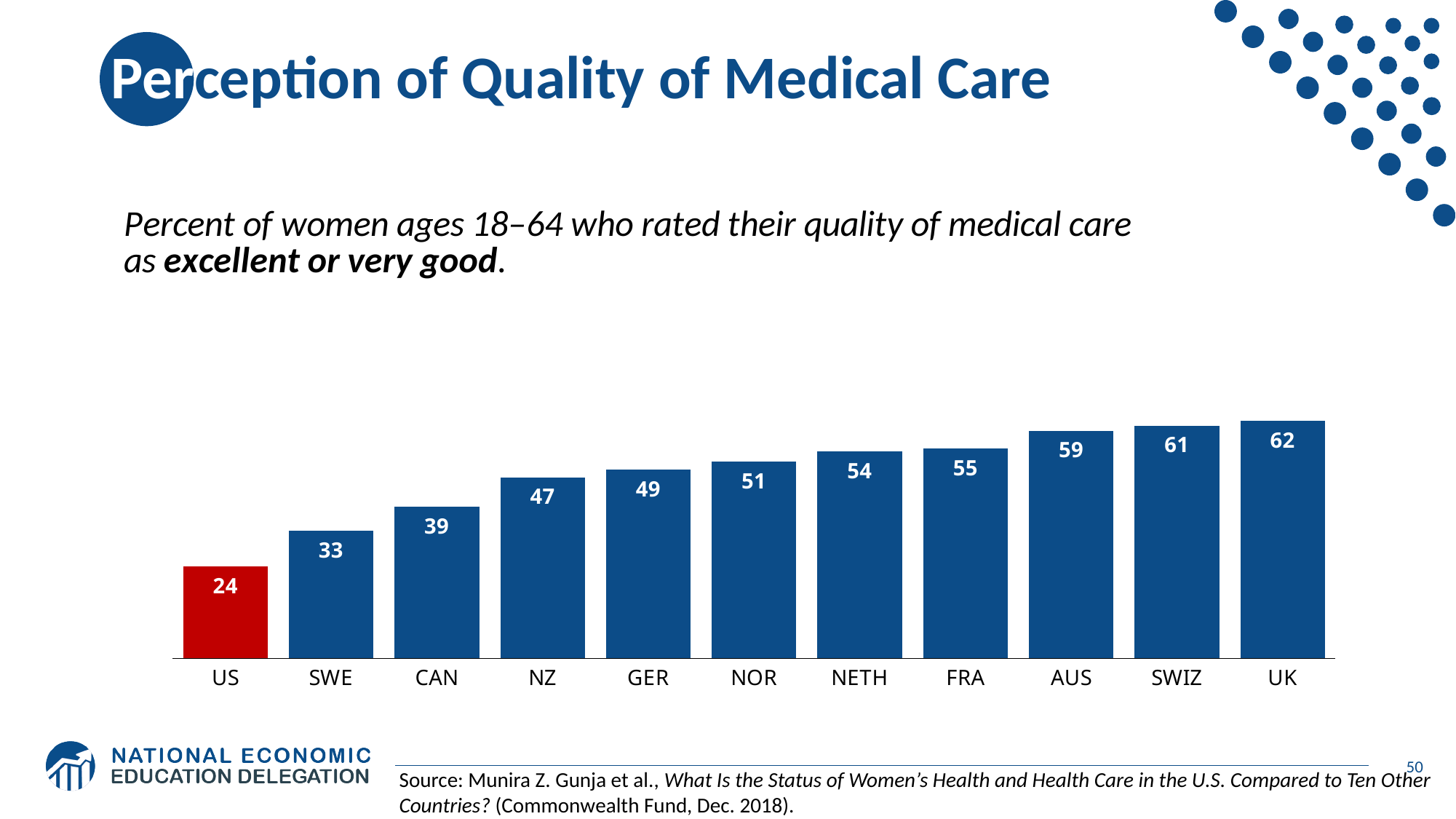
Which country has the lowest value? US How many countries are shown in the chart? 11 Which is larger, the value for SWE or the value for NZ? NZ Which bar is coloured red rather than blue? US What is the difference between the values for NETH and CAN? 15 Do the values rise or fall from left to right along the x axis? rise What is the value for GER? 49 What is the difference between the values for UK and US? 38 Which country has the highest value? UK What kind of chart is shown on the slide? bar chart What is the value for the US? 24 What is the value for AUS? 59